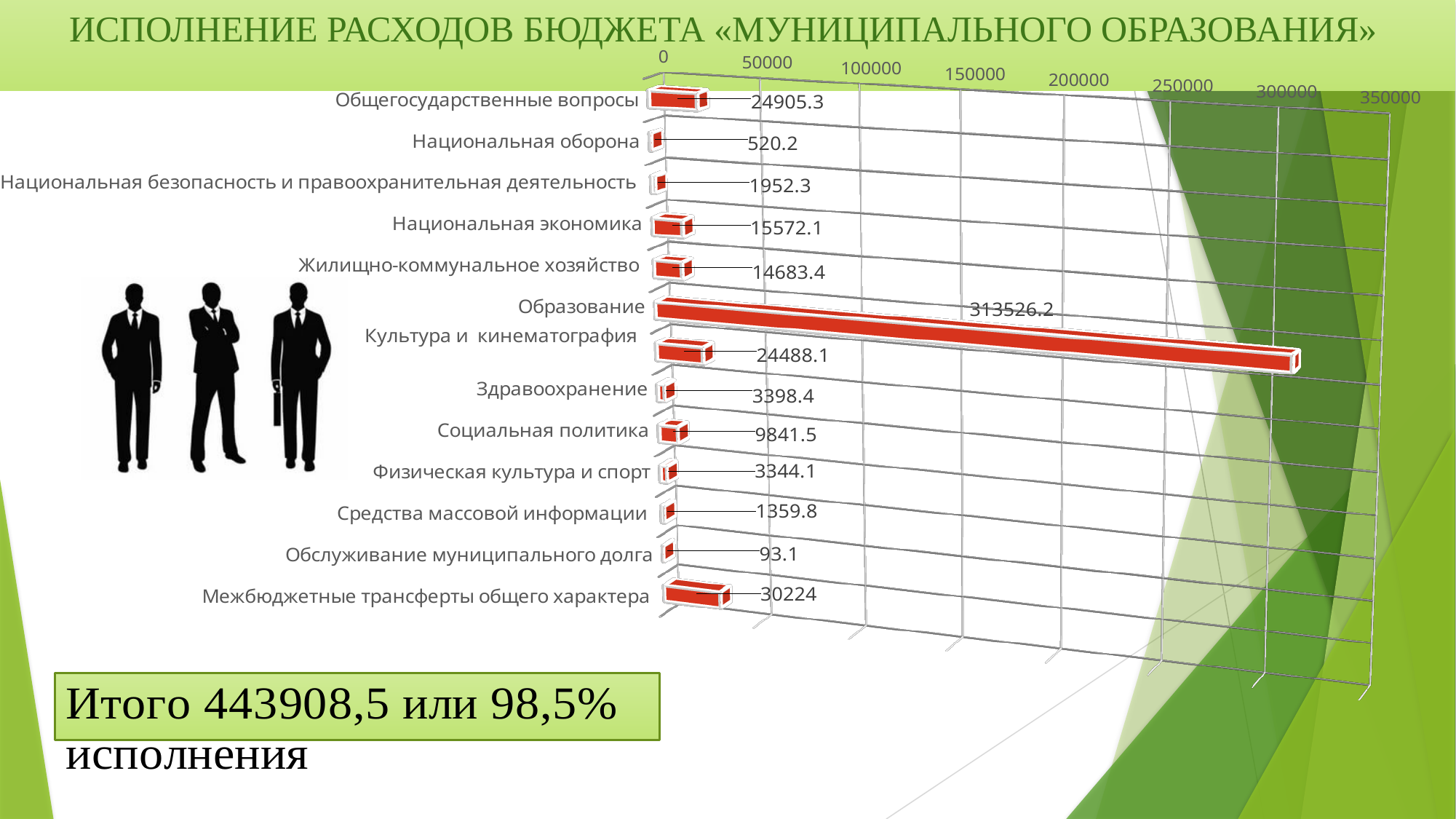
Which category has the highest value? Образование What is the value for Межбюджетные трансферты общего характера? 30224 Which category has the lowest value? Обслуживание муниципального долга Is the value for Образование greater or less than 300000? greater What is the difference between the values for Межбюджетные трансферты общего характера and Общегосударственные вопросы? 5318.7 What is the value for Обслуживание муниципального долга? 93.1 What kind of chart is shown on the slide? bar chart Which is larger, the value for Социальная политика or the value for Здравоохранение? Социальная политика What is the difference between the values for Национальная экономика and Жилищно-коммунальное хозяйство? 888.7 How many categories are shown in the chart? 13 What is the value for Социальная политика? 9841.5 What is the value for Образование? 313526.2